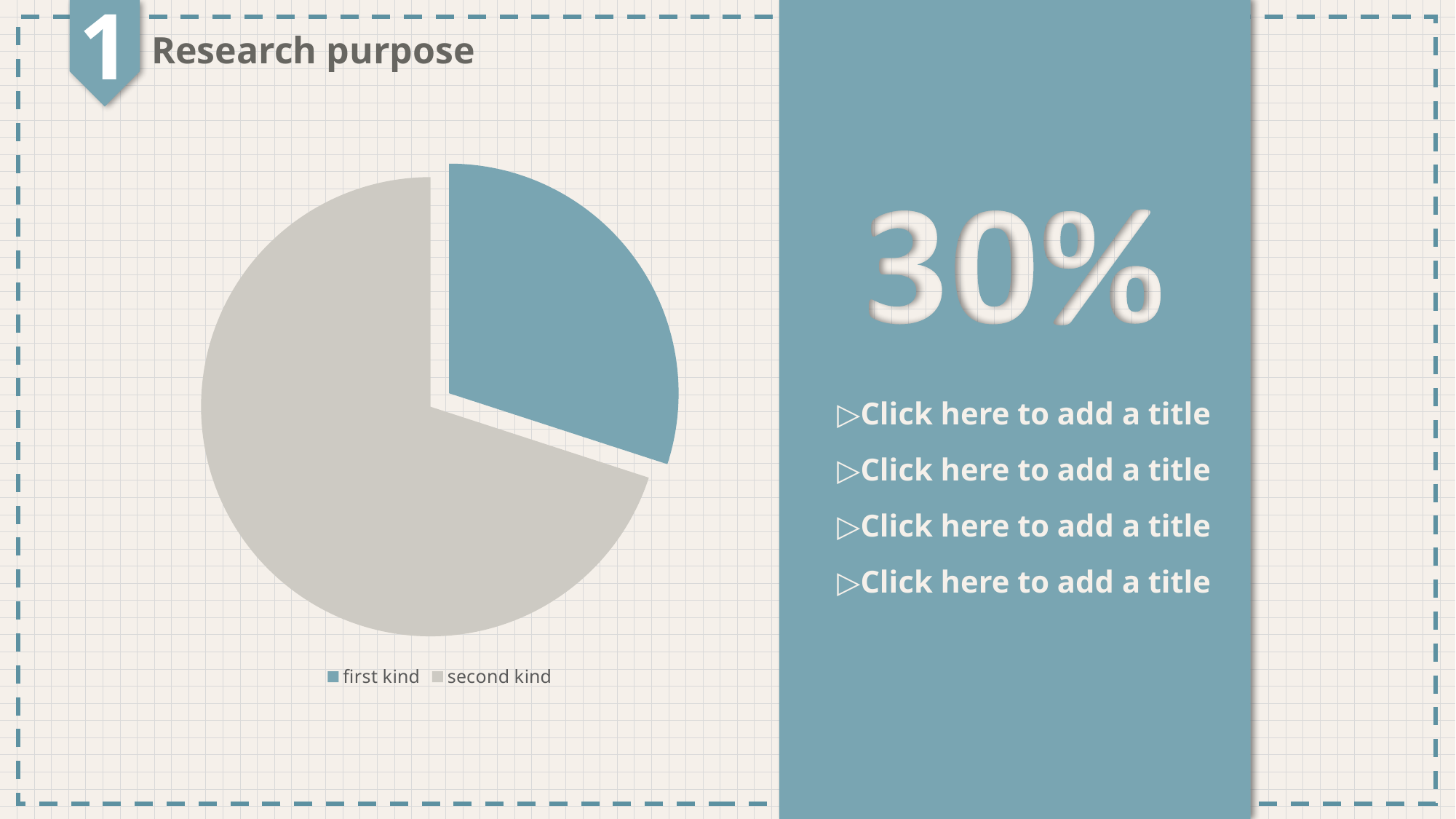
Which slice of the pie chart is pulled out (exploded) from the rest of the pie? first kind How many slices does the pie chart have? 2 What kind of chart is shown on the slide? pie chart How many entries does the legend of the pie chart list? 2 Which slice of the pie chart is the largest? second kind Which legend entry is shown in blue in the pie chart? first kind Which slice of the pie chart is the smallest? first kind Which slice is larger in the pie chart, first kind or second kind? second kind